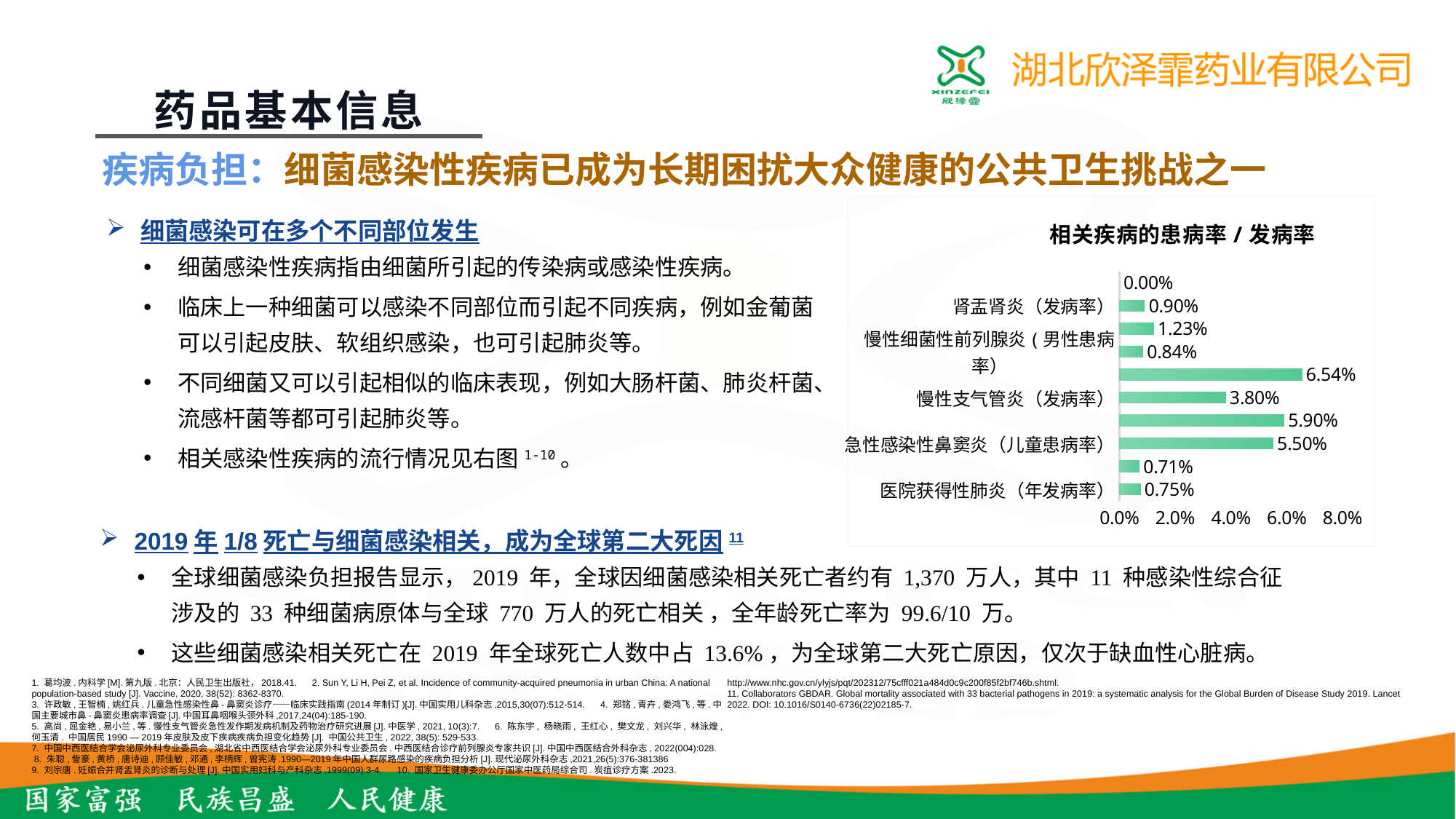
How many bars are plotted in the chart? 10 What is the largest value labelled on any bar in the chart? 6.54% What is the value shown for 医院获得性肺炎（年发病率）? 0.75% What kind of chart is shown on the slide? bar chart What is the value shown for 肾盂肾炎（发病率）? 0.90% What is the value shown for 慢性细菌性前列腺炎（男性患病率）? 0.84% What is the title of the chart on the slide? 相关疾病的患病率 / 发病率 What is the value shown for 慢性支气管炎（发病率）? 3.80% What is the maximum value shown on the horizontal axis of the chart? 8.0% What is the difference between the value for 急性感染性鼻窦炎（儿童患病率） and the value for 医院获得性肺炎（年发病率）? 4.75% Which is larger, the value for 慢性支气管炎（发病率） or the value for 肾盂肾炎（发病率）? 慢性支气管炎（发病率） What is the value shown for 急性感染性鼻窦炎（儿童患病率）? 5.50%